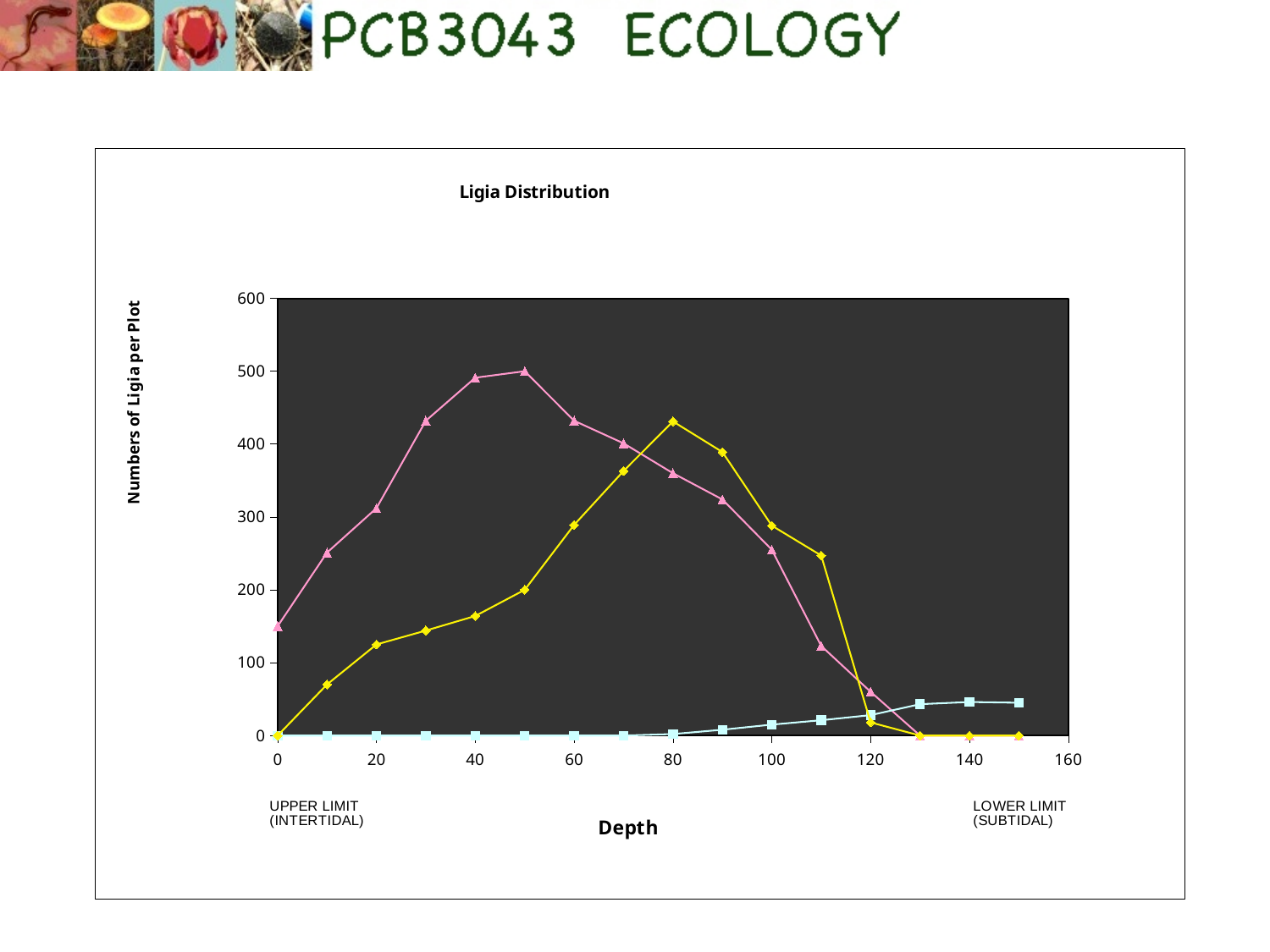
At depth 40, which series has the larger value, the pink triangle series or the yellow diamond series? pink triangle series Is the value of the light blue square series at depth 140 greater or less than 100? less What is the label of the vertical axis? Numbers of Ligia per Plot Is the value of the pink triangle series at depth 50 greater or less than 400? greater Is the value of the yellow diamond series at depth 20 greater or less than 200? less At which depth does the yellow diamond series reach its highest value? 80 What is the title of the chart? Ligia Distribution Does the pink triangle series rise or fall between depth 50 and depth 130? fall How many data series (lines) are plotted on the chart? 3 At depth 90, which series has the larger value, the yellow diamond series or the pink triangle series? yellow diamond series What kind of chart is shown on the slide? line chart